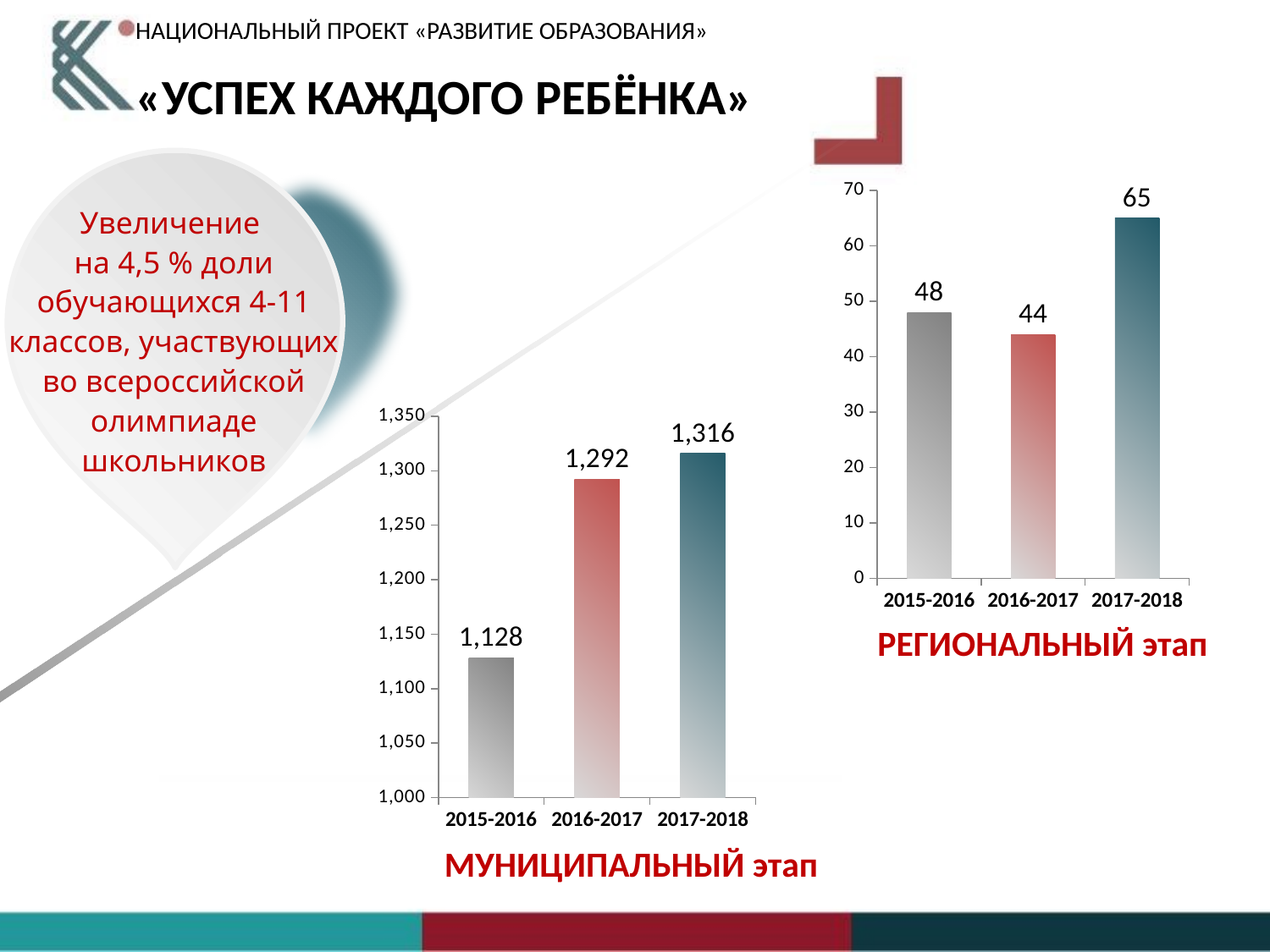
What kind of chart is the МУНИЦИПАЛЬНЫЙ этап chart? bar chart In the МУНИЦИПАЛЬНЫЙ этап chart, which year has the highest value? 2017-2018 In the МУНИЦИПАЛЬНЫЙ этап chart, what is the difference between the 2017-2018 and 2015-2016 values? 188 In the РЕГИОНАЛЬНЫЙ этап chart, what is the difference between the 2015-2016 and 2016-2017 values? 4 In the РЕГИОНАЛЬНЫЙ этап chart, which is larger, the value for 2015-2016 or 2017-2018? 2017-2018 How many categories are shown in the РЕГИОНАЛЬНЫЙ этап chart? 3 In the РЕГИОНАЛЬНЫЙ этап chart, is the value for 2017-2018 greater or less than 60? greater In the МУНИЦИПАЛЬНЫЙ этап chart, what is the value for 2016-2017? 1,292 In the МУНИЦИПАЛЬНЫЙ этап chart, what is the value for 2015-2016? 1,128 In the РЕГИОНАЛЬНЫЙ этап chart, what is the value for 2017-2018? 65 In the МУНИЦИПАЛЬНЫЙ этап chart, do the values rise or fall from 2015-2016 to 2017-2018? rise In the РЕГИОНАЛЬНЫЙ этап chart, which year has the lowest value? 2016-2017